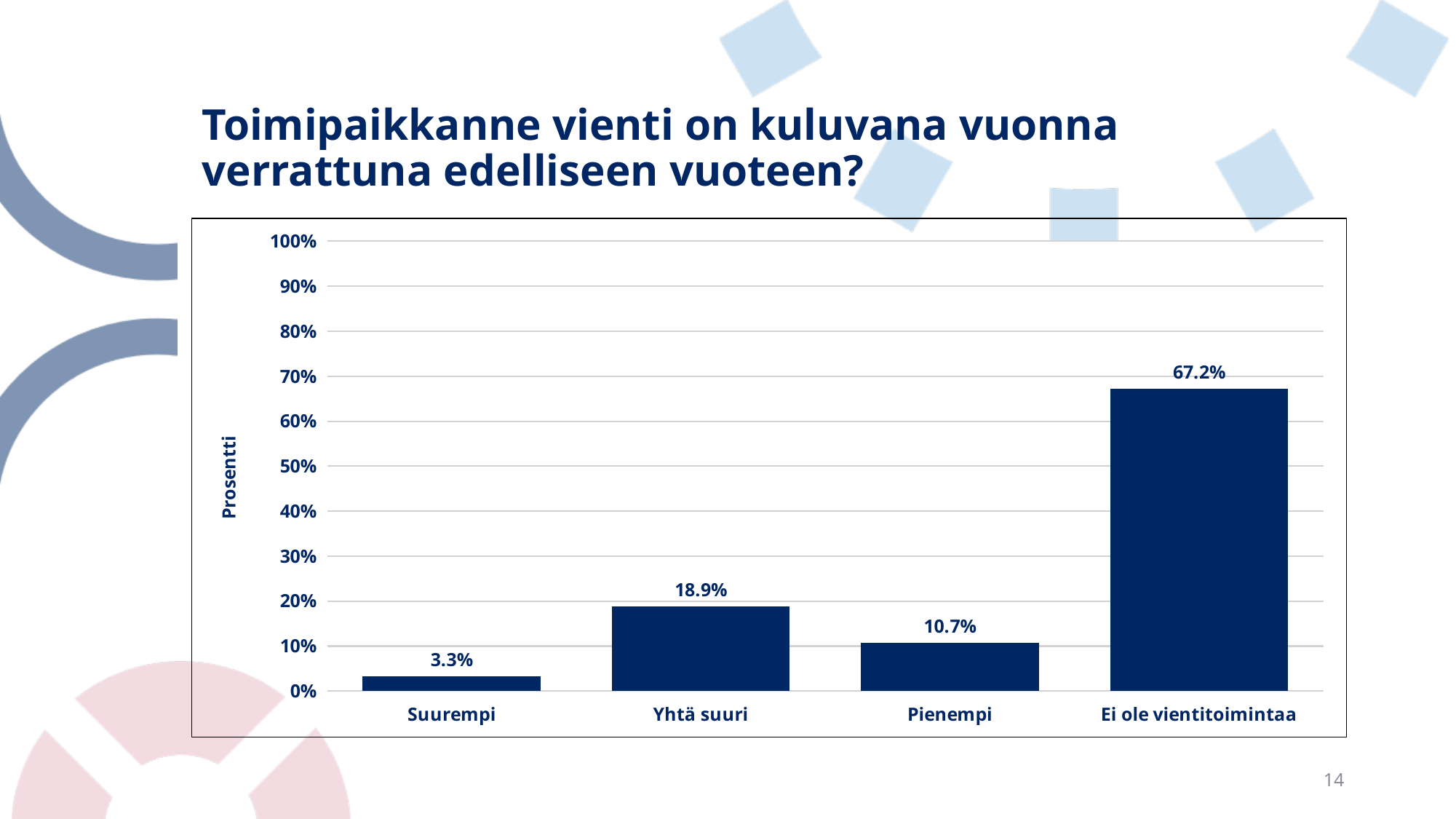
What is the value for Pienempi? 10.7% What kind of chart is shown on the slide? bar chart What is the value for Suurempi? 3.3% How many categories are shown on the x axis? 4 What is the value for Yhtä suuri? 18.9% What is the difference between the values for Yhtä suuri and Pienempi? 8.2% Which category has the lowest value? Suurempi Is the value for Ei ole vientitoimintaa greater or less than 60%? greater Which is larger, the value for Yhtä suuri or the value for Pienempi? Yhtä suuri Which category has the highest value? Ei ole vientitoimintaa What is the label of the vertical axis? Prosentti What is the value for Ei ole vientitoimintaa? 67.2%